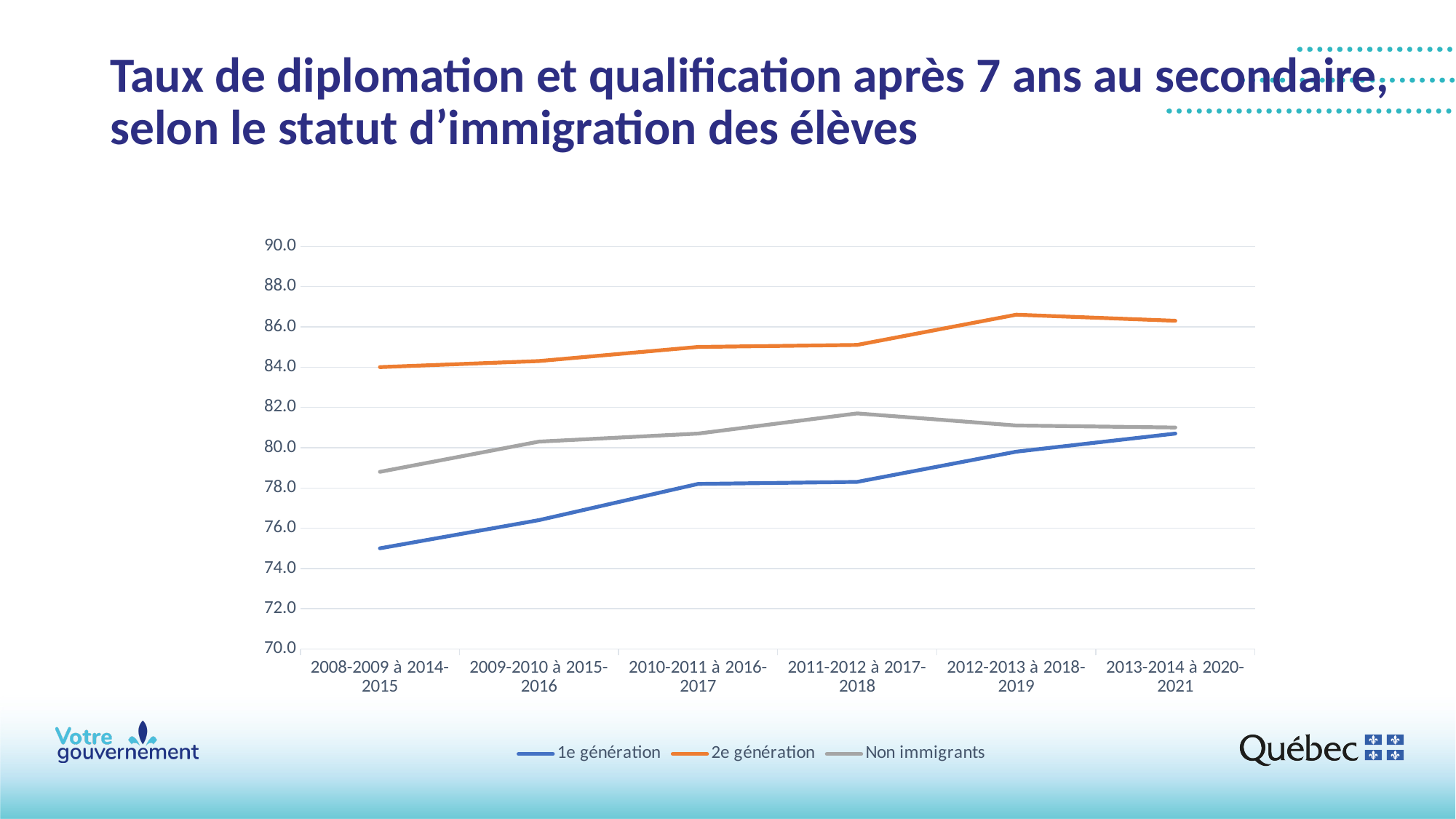
How many series does the legend list? 3 Which series has the lowest value for 2008-2009 à 2014-2015? 1e génération What colour is the line for Non immigrants? grey Which is larger in 2010-2011 à 2016-2017: the value for Non immigrants or the value for 1e génération? Non immigrants What kind of chart is shown on the slide? line chart Does the 1e génération series rise or fall from 2008-2009 à 2014-2015 to 2013-2014 à 2020-2021? rise Is the value for 2e génération in 2012-2013 à 2018-2019 greater or less than 86.0? greater In which period does the 2e génération series reach its highest value? 2012-2013 à 2018-2019 Is the value for Non immigrants in 2011-2012 à 2017-2018 greater or less than 82.0? less Is the value for 1e génération in 2008-2009 à 2014-2015 greater or less than 76.0? less How many cohort periods are shown along the x axis? 6 Which series has the highest values across all periods? 2e génération